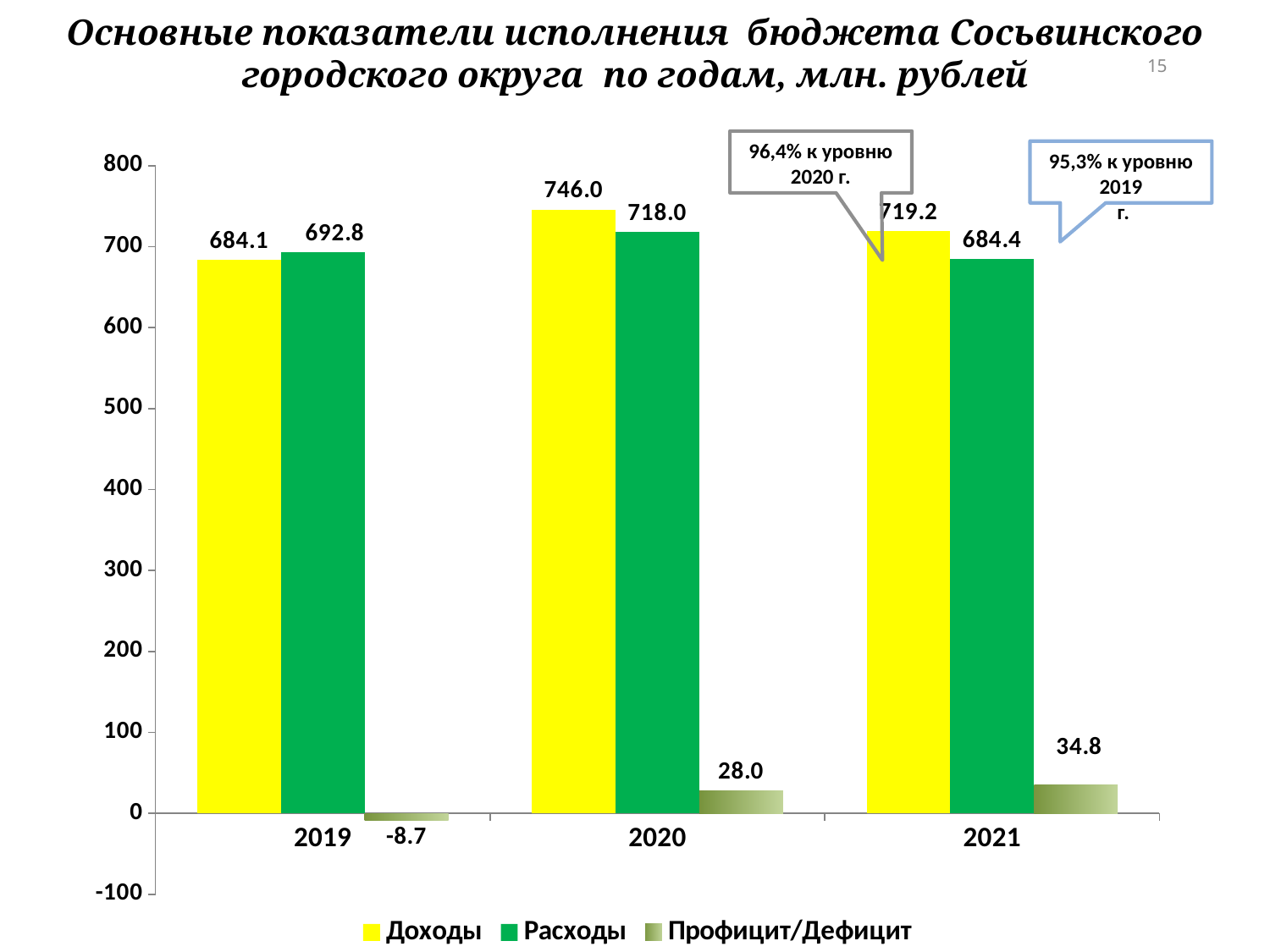
What is the value of Профицит/Дефицит for 2019? -8.7 Is the value of Расходы for 2020 greater or less than 700? greater What is the value of Доходы for 2020? 746.0 How many years are shown on the x axis? 3 In which year is Расходы lowest? 2021 Which is larger in 2019, Доходы or Расходы? Расходы How many series does the legend list? 3 What is the value of Расходы for 2021? 684.4 What kind of chart is shown on the slide? bar chart In which year is Доходы highest? 2020 Which colour represents Доходы in the chart? yellow What is the difference between Доходы and Расходы in 2020? 28.0